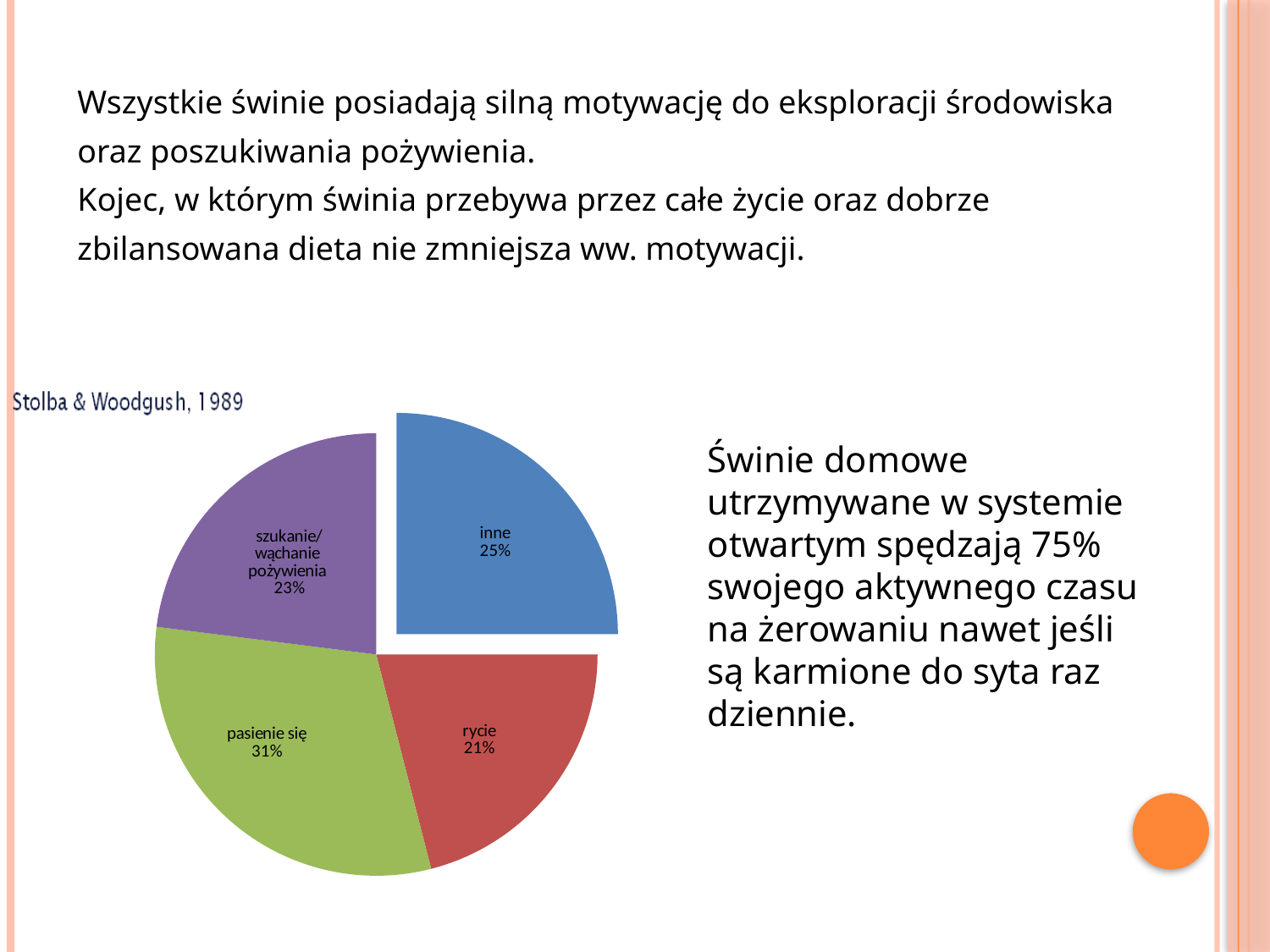
What is the difference in percentage points between "pasienie się" and "rycie"? 10 Which is larger, the share for "inne" or the share for "szukanie/wąchanie pożywienia"? inne What share of the pie does "inne" represent? 25% What colour is the "inne" slice of the pie chart? blue What share of the pie does "rycie" represent? 21% What share of the pie does "szukanie/wąchanie pożywienia" represent? 23% What kind of chart is shown on the slide? pie chart What is the combined share of "pasienie się", "rycie" and "szukanie/wąchanie pożywienia"? 75% Which slice of the pie chart is the smallest? rycie How many slices does the pie chart have? 4 Which slice of the pie chart is the largest? pasienie się